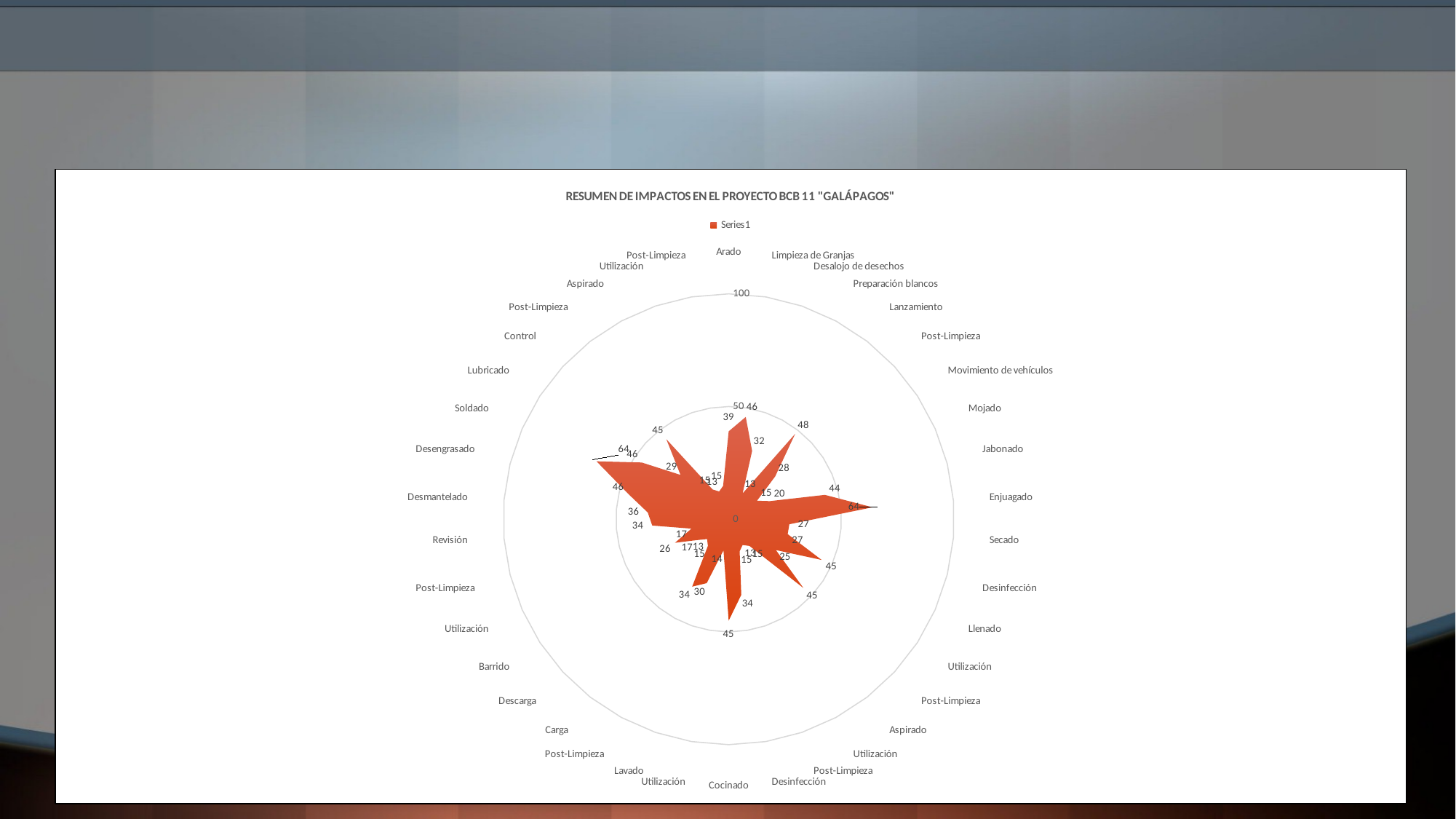
What is the title of the chart? RESUMEN DE IMPACTOS EN EL PROYECTO BCB 11 "GALÁPAGOS" How many categories are plotted around the radar chart? 38 What is the value for Arado? 39 What is the value for Enjuagado? 64 What is the value for Cocinado? 45 What is the difference between the values for Enjuagado and Cocinado? 19 What kind of chart is shown on the slide? Radar chart What is the highest value labelled on the chart? 64 How many series does the legend list? 1 Is the value for Enjuagado greater or less than 50? greater What is the name of the series shown in the legend? Series1 Which has the larger value, Enjuagado or Arado? Enjuagado